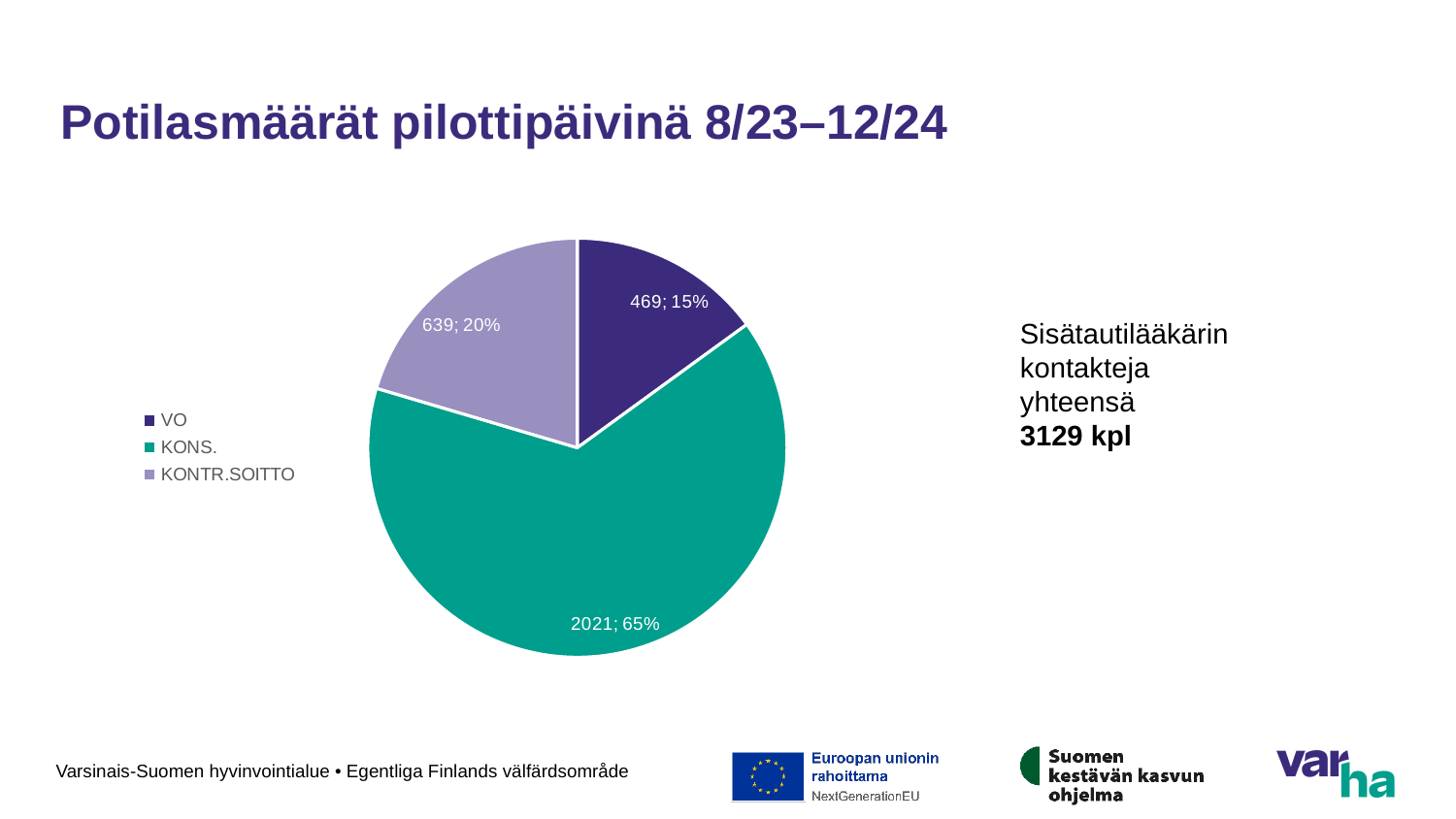
What is the value for KONS.? 2021 How many slices does the pie chart have? 3 What share of the pie does KONS. represent? 65% What is the difference between the values for KONTR.SOITTO and VO? 170 What share of the pie does VO represent? 15% What kind of chart is shown on the slide? pie chart How many entries does the legend list? 3 Which category has the smallest slice? VO Which category has the largest slice? KONS. What is the value for KONTR.SOITTO? 639 Which is larger, the value for KONTR.SOITTO or the value for VO? KONTR.SOITTO What is the value for VO? 469